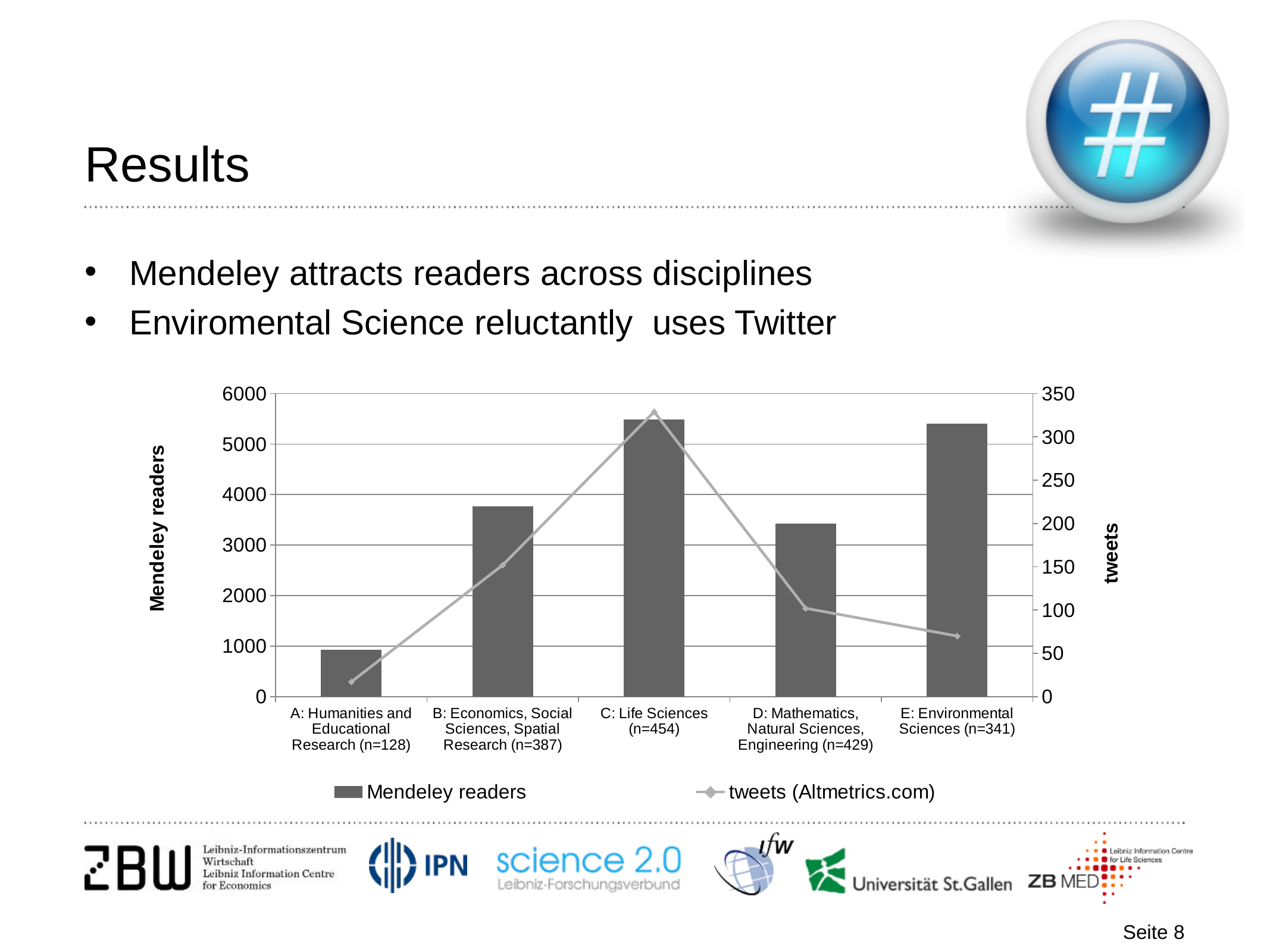
Which category has the lowest number of Mendeley readers? A: Humanities and Educational Research (n=128) Which category has the highest number of tweets? C: Life Sciences (n=454) What kind of chart is shown on the slide? A bar chart combined with a line chart Is the number of Mendeley readers for A: Humanities and Educational Research greater or less than 1000? less How many categories are shown on the x axis of the chart? 5 Is the number of tweets for C: Life Sciences greater or less than 300? greater Which has more tweets, B: Economics, Social Sciences, Spatial Research or D: Mathematics, Natural Sciences, Engineering? B: Economics, Social Sciences, Spatial Research Which category has the lowest number of tweets? A: Humanities and Educational Research (n=128) What is the title of the right-hand vertical axis? tweets Is the number of tweets for E: Environmental Sciences greater or less than 100? less How many series does the chart legend list? 2